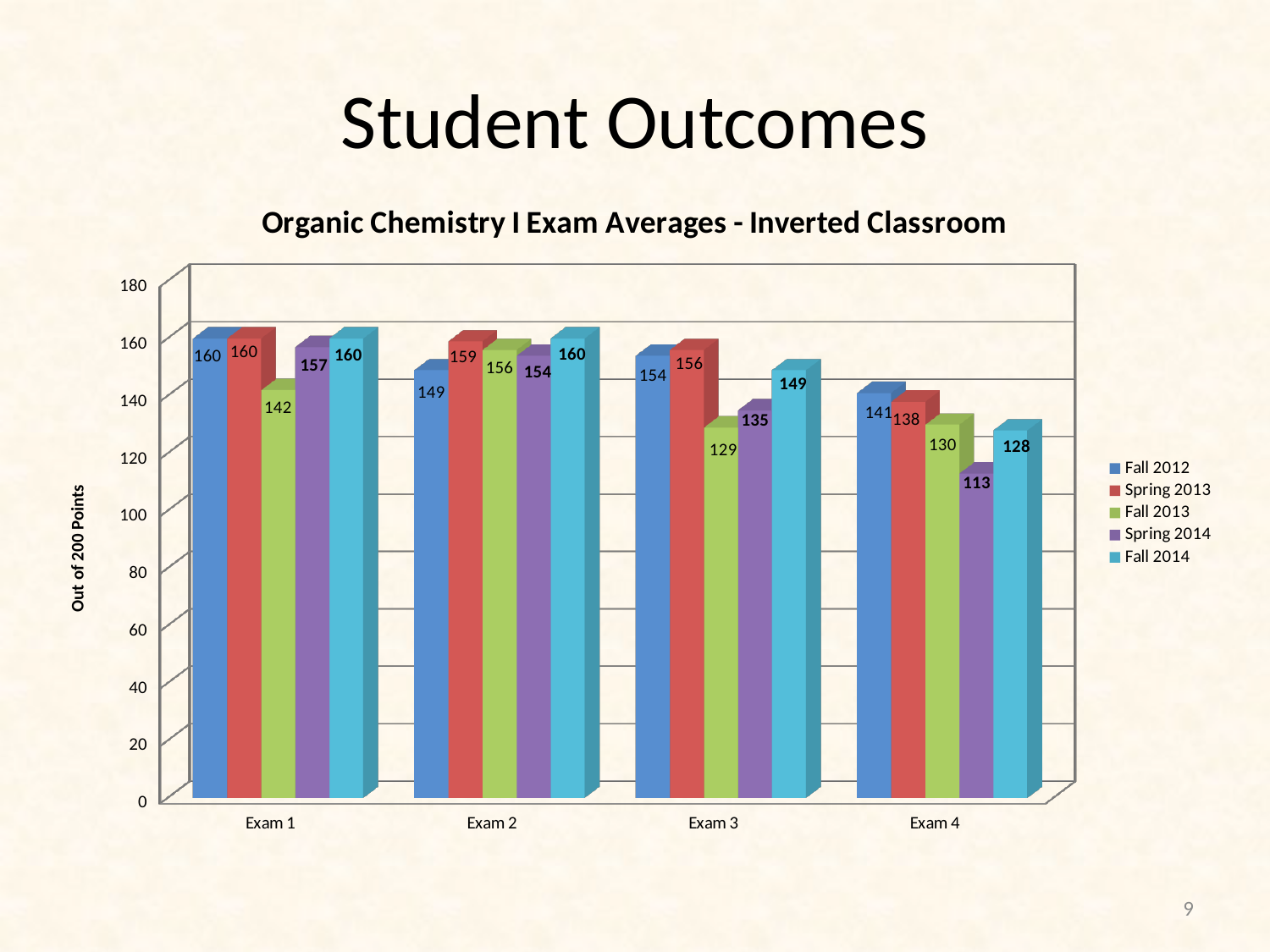
What is the Spring 2014 exam average for Exam 4? 113 What is the label on the vertical axis of the chart? Out of 200 Points What kind of chart is shown on the slide? Bar chart Which is larger for Exam 2: the Spring 2013 average or the Fall 2012 average? Spring 2013 What is the difference between the Spring 2013 and Fall 2013 averages for Exam 3? 27 How many series does the legend list? 5 Which series has the lowest average for Exam 3? Fall 2013 How many exams are shown on the x axis? 4 Which series has the lowest average for Exam 4? Spring 2014 What is the Fall 2013 exam average for Exam 1? 142 What is the Fall 2012 exam average for Exam 2? 149 What is the Fall 2014 exam average for Exam 3? 149